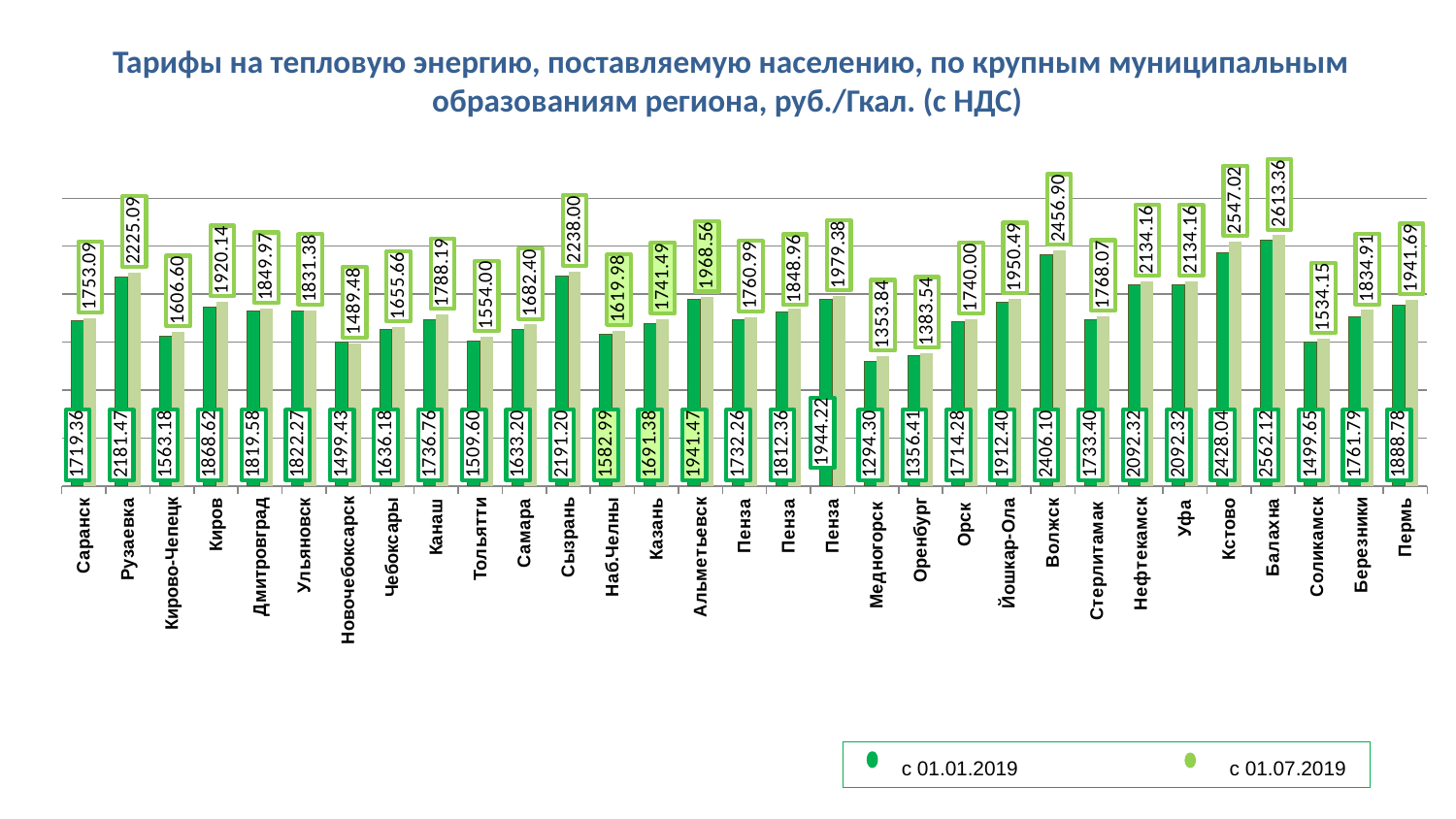
What are the two entries listed in the legend? с 01.01.2019 and с 01.07.2019 What is the tariff for Тольятти in the series 'с 01.07.2019'? 1554.00 Which has the larger tariff in the series 'с 01.01.2019': Сызрань or Рузаевка? Сызрань What is the tariff for Саранск in the series 'с 01.01.2019'? 1719.36 Which municipality has the highest tariff in the series 'с 01.07.2019'? Балахна How many series does the legend list? 2 What kind of chart is shown on the slide? Bar chart What is the tariff for Волжск in the series 'с 01.07.2019'? 2456.90 What is the difference between the 'с 01.07.2019' and 'с 01.01.2019' tariffs for Кстово? 118.98 What is the difference between the 'с 01.07.2019' and 'с 01.01.2019' tariffs for Балахна? 51.24 Which municipality has the lowest tariff in the series 'с 01.01.2019'? Медногорск How many municipalities (categories) are shown on the x axis? 31